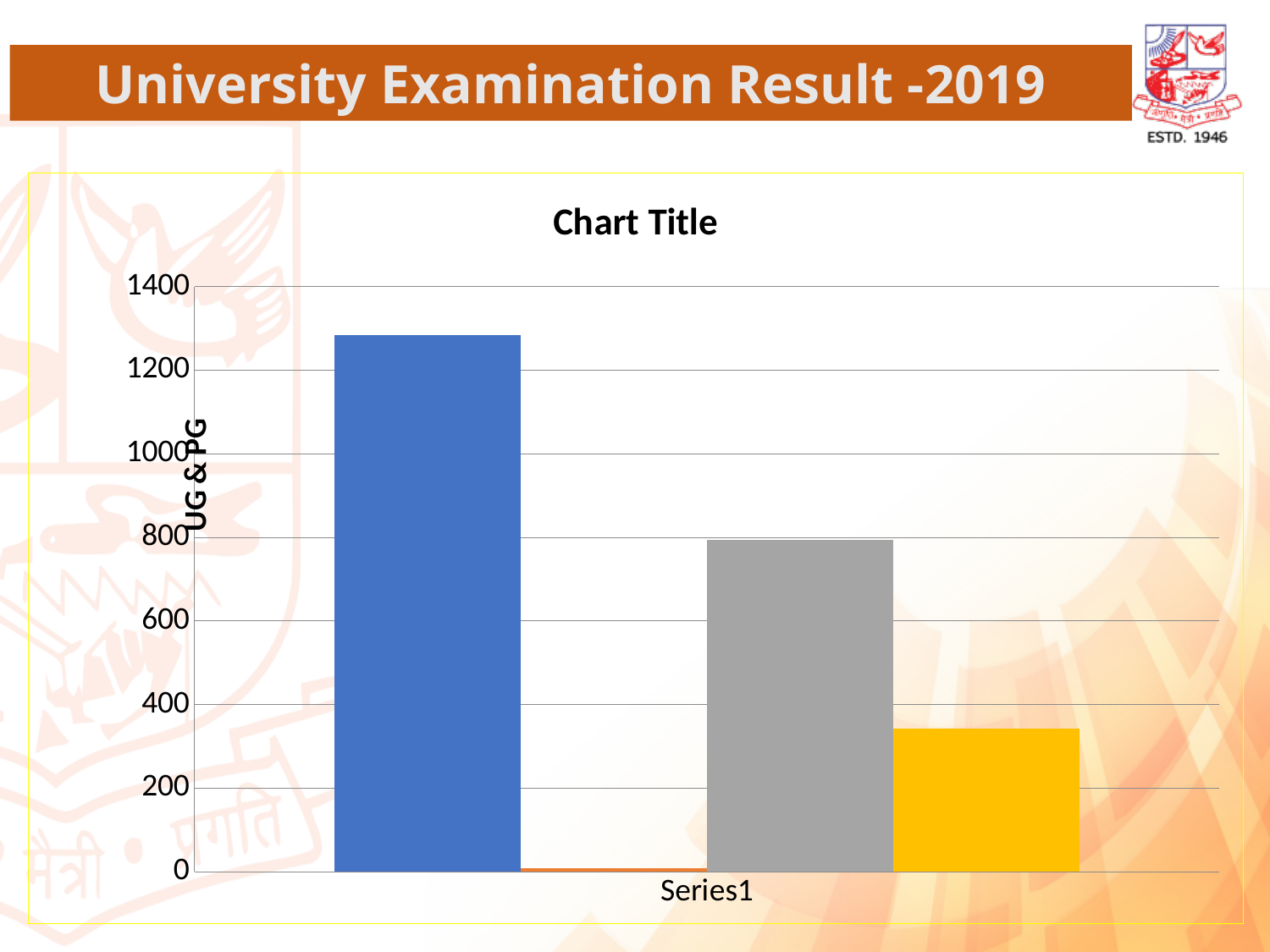
What kind of chart is shown on the slide? bar chart Is the value of the gray bar greater or less than 600? greater Is the value of the yellow bar greater or less than 400? less Is the value of the orange bar greater or less than 200? less What is the title of the vertical axis? UG & PG Which is larger, the gray bar or the yellow bar? the gray bar Which bar is the tallest in the chart? the blue bar How many bars are plotted in the chart? 4 Which bar is the shortest in the chart? the orange bar What label appears under the bars on the horizontal axis? Series1